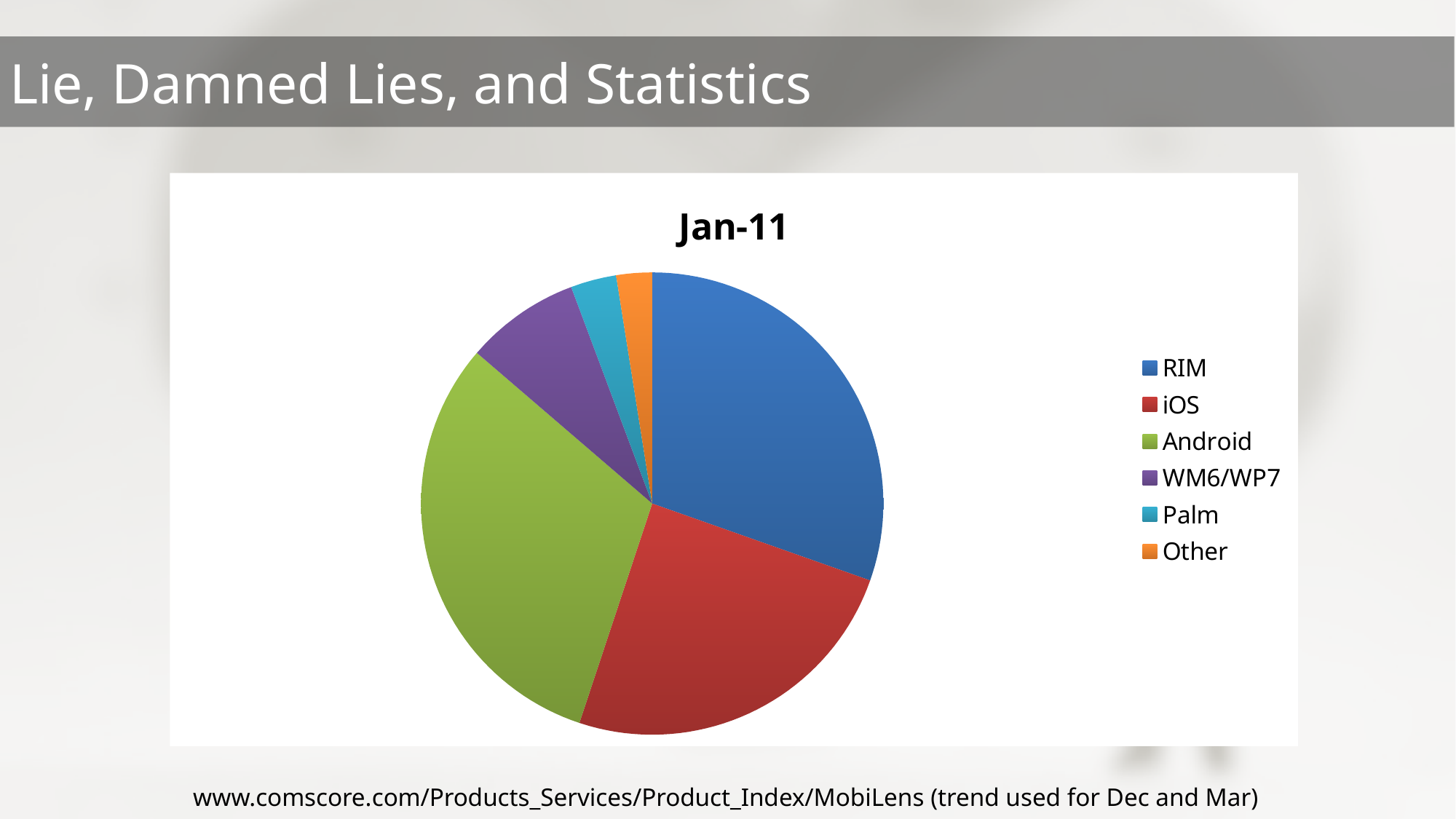
Which slice is larger, iOS or Palm? iOS Which slice is larger, iOS or Android? Android Which slice is larger, RIM or iOS? RIM What kind of chart is shown on the slide? pie chart How many slices does the pie chart have? 6 How many entries does the legend list? 6 What is the title of the chart? Jan-11 What colour is the RIM slice in the pie chart? blue